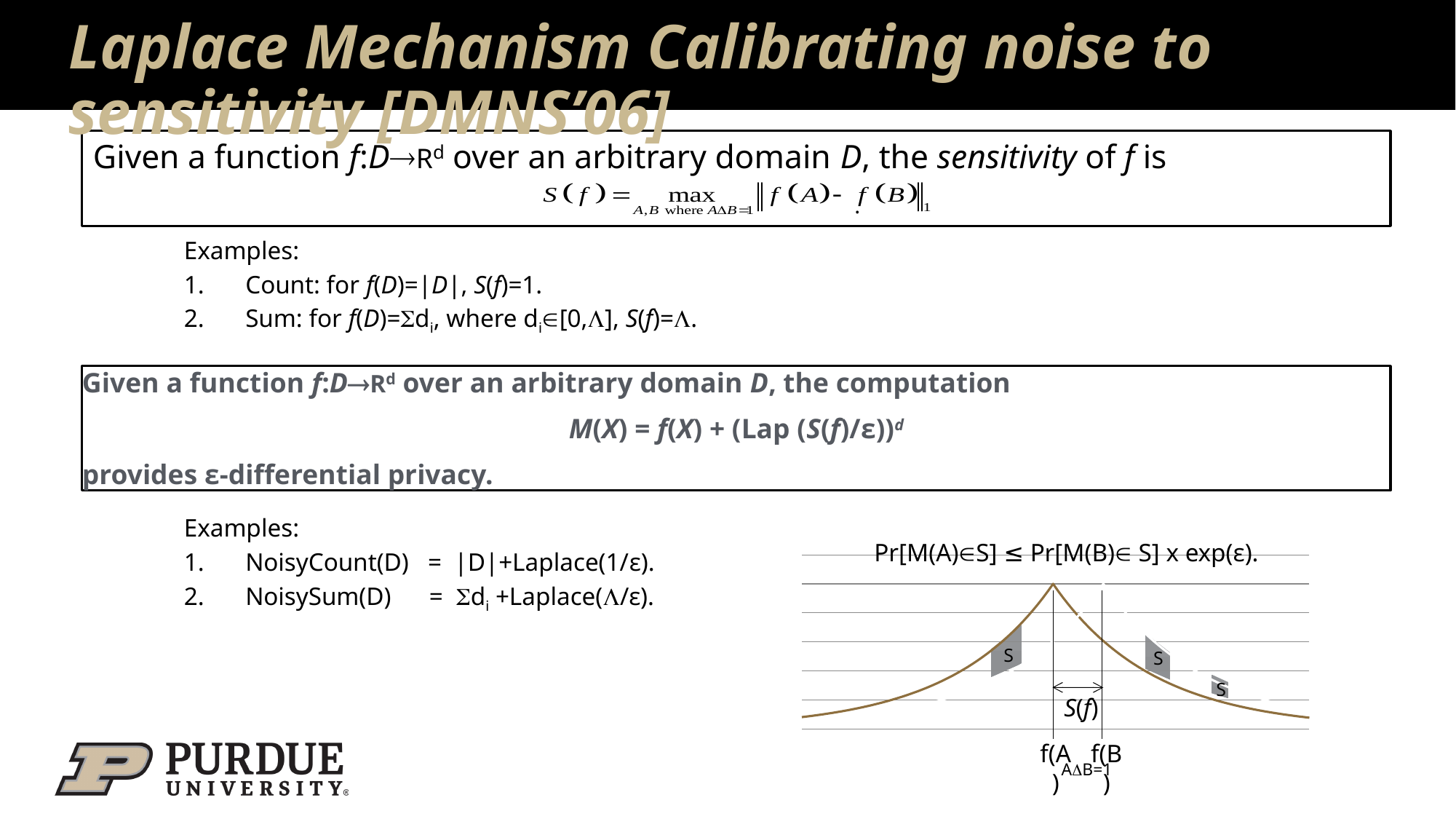
In the chart at the bottom right, does the curve rise or fall as you move to the right of its peak? fall What kind of chart is shown at the bottom right of the slide? line chart In the chart at the bottom right, what inequality is written above the curve? Pr[M(A)∈S] ≤ Pr[M(B)∈ S] x exp(ε). In the chart at the bottom right, does the curve rise or fall as you move from the left edge toward the peak? rise In the chart at the bottom right, how many shaded regions labelled S are drawn on the curve? 3 In the chart at the bottom right, what label is written under the double-headed arrow between the two vertical lines? S(f)